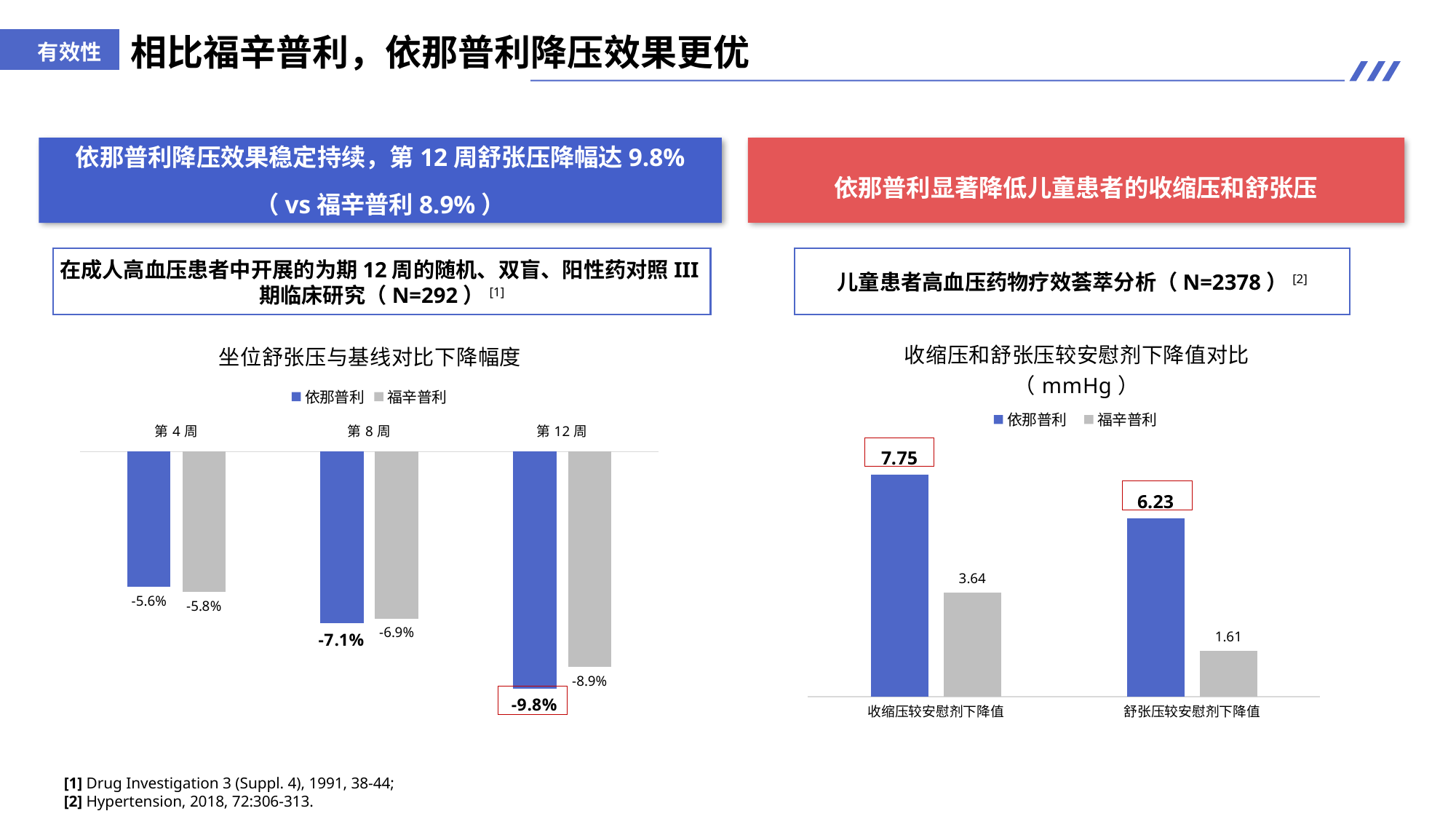
In the right chart (收缩压和舒张压较安慰剂下降值对比), what is the difference between the 依那普利 and 福辛普利 values for 收缩压较安慰剂下降值? 4.11 In the left chart (坐位舒张压与基线对比下降幅度), what is the difference between the 依那普利 and 福辛普利 values at 第 12 周? 0.9% In the left chart (坐位舒张压与基线对比下降幅度), do the 依那普利 values become more negative or less negative from 第 4 周 to 第 12 周? more negative In the left chart (坐位舒张压与基线对比下降幅度), what is the value for 依那普利 at 第 12 周? -9.8% In the right chart (收缩压和舒张压较安慰剂下降值对比), what is the value for 依那普利 for 收缩压较安慰剂下降值? 7.75 In the left chart (坐位舒张压与基线对比下降幅度), what is the value for 依那普利 at 第 8 周? -7.1% In the right chart (收缩压和舒张压较安慰剂下降值对比), which series has the larger value for 舒张压较安慰剂下降值? 依那普利 In the left chart (坐位舒张压与基线对比下降幅度), how many time-point categories are shown on the x axis? 3 In the right chart (收缩压和舒张压较安慰剂下降值对比), what is the value for 福辛普利 for 舒张压较安慰剂下降值? 1.61 In the left chart (坐位舒张压与基线对比下降幅度), what is the value for 福辛普利 at 第 4 周? -5.8% What type of chart is the right chart (收缩压和舒张压较安慰剂下降值对比)? bar chart In the right chart (收缩压和舒张压较安慰剂下降值对比), how many series does the legend list? 2